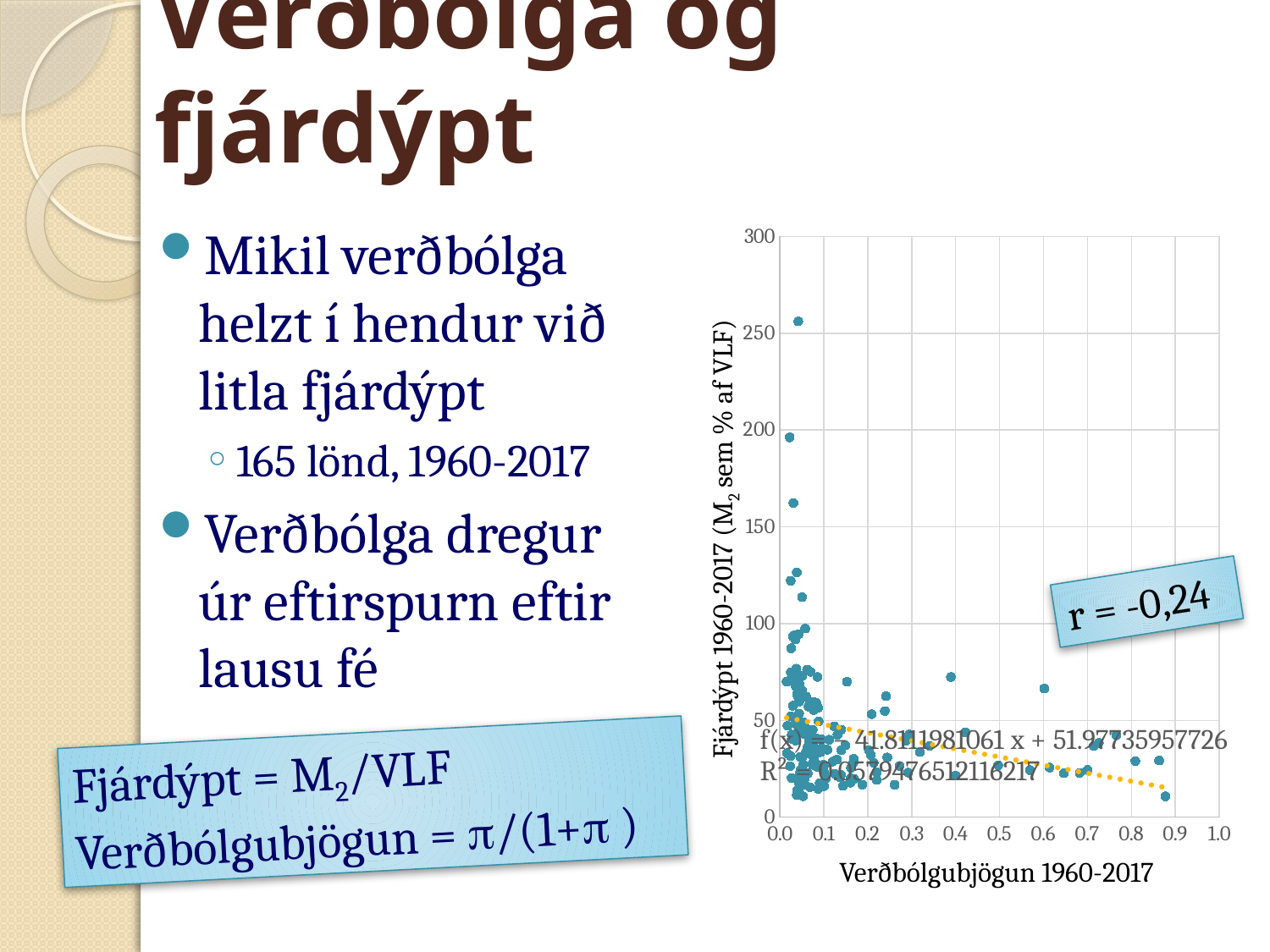
What kind of chart is shown on the slide? scatter plot What is the intercept of the fitted line f(x) printed on the chart? 51.97735957726 What is the label of the x axis of the chart? Verðbólgubjögun 1960-2017 What is the highest tick value shown on the x axis of the chart? 1.0 What R² value is printed on the chart? 0.0579476512116217 Is the Verðbólgubjögun value of the rightmost point in the scatter plot greater or less than 0.8? greater Is the Fjárdýpt value of the rightmost point (near x = 0.88) greater or less than 50? less What correlation coefficient r is shown in the callout on the chart? r = -0,24 According to the dotted trend line, do the values of Fjárdýpt rise or fall as Verðbólgubjögun increases along the x axis? fall What is the slope of the fitted line f(x) printed on the chart? -41.8111981061 Is the Fjárdýpt value of the highest point in the scatter plot greater or less than 250? greater What is the highest tick value shown on the y axis of the chart? 300